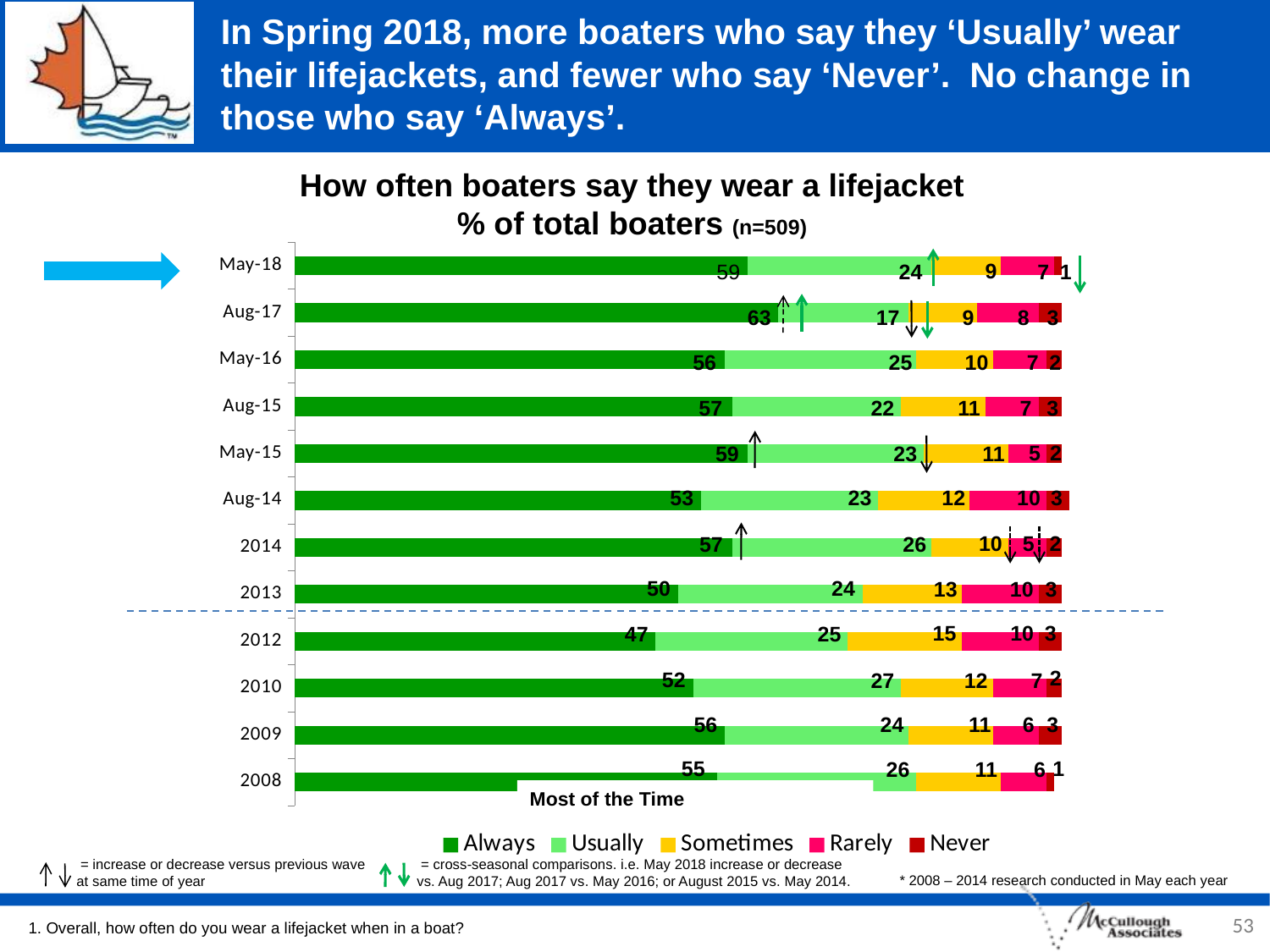
What kind of chart is shown on the slide? Stacked bar chart What is the difference between the 'Usually' values for May-18 and Aug-17? 7 How many series does the legend list? 5 What is the 'Usually' value for Aug-17? 17 Which wave has the highest 'Always' value? Aug-17 What is the sample size (n) given in the chart title? n=509 What percentage of boaters said they 'Always' wear a lifejacket in May-18? 59 Which is larger, the 'Sometimes' value for 2012 or for 2010? 2012 Which wave has the lowest 'Always' value? 2012 What is the 'Never' value for Aug-14? 3 How many waves (categories) are shown on the chart? 12 What is the total of the 'Always' and 'Usually' segments for May-18? 83